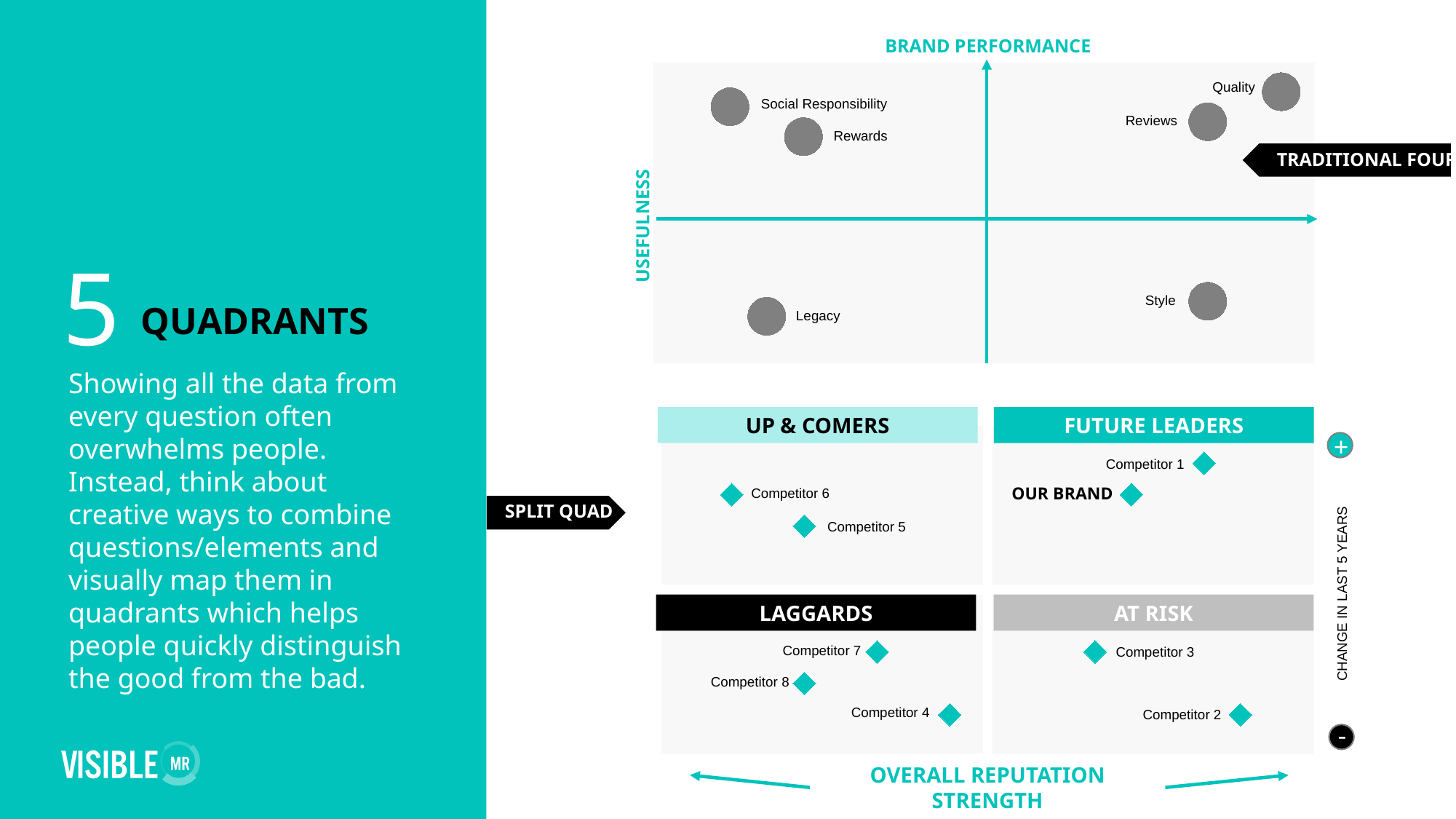
On the Split Quad chart (bottom), which quadrant contains OUR BRAND? FUTURE LEADERS On the Split Quad chart (bottom), which quadrant contains Competitor 3? AT RISK On the Split Quad chart (bottom), how many points are plotted? 9 On the Traditional Four chart (top), which point has the highest brand performance? Quality On the Traditional Four chart (top), which has higher usefulness, Rewards or Legacy? Rewards On the Split Quad chart (bottom), which point has the highest change in the last 5 years? Competitor 1 On the Traditional Four chart (top), how many points are plotted? 6 On the Split Quad chart (bottom), how many points are in the LAGGARDS quadrant? 3 On the Split Quad chart (bottom), what is the label of the horizontal axis? OVERALL REPUTATION STRENGTH On the Traditional Four chart (top), what is the label of the vertical axis? USEFULNESS On the Split Quad chart (bottom), which quadrant contains Competitor 6? UP & COMERS On the Traditional Four chart (top), which point has the lowest brand performance? Social Responsibility